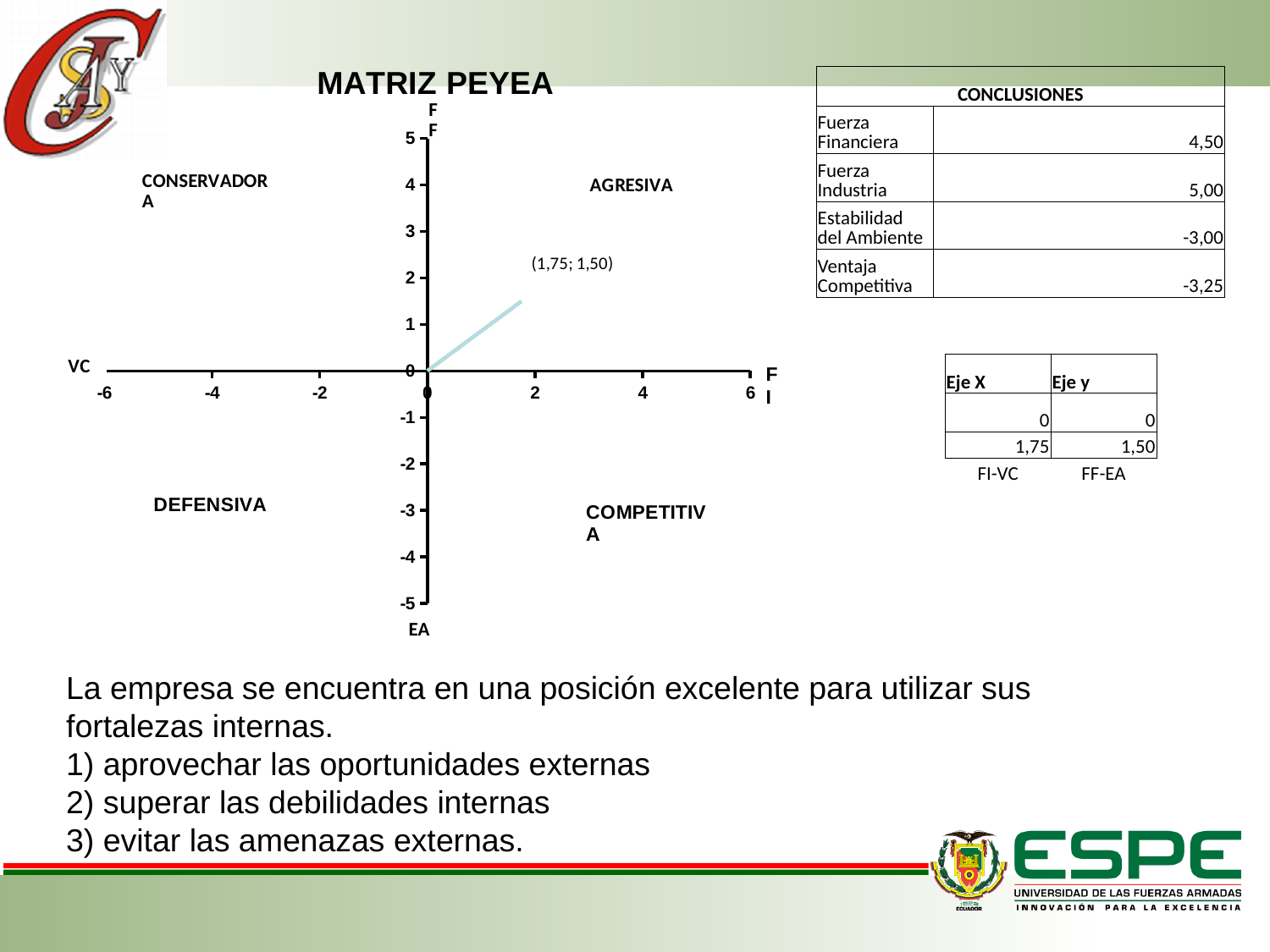
What is the x-coordinate of the labelled point in the MATRIZ PEYEA chart? 1,75 What is the difference between the x-coordinate and the y-coordinate of the labelled point in the MATRIZ PEYEA chart? 0,25 Does the plotted line in the MATRIZ PEYEA chart rise or fall as it moves from left to right? rise Which is larger for the labelled point in the MATRIZ PEYEA chart, the x-coordinate or the y-coordinate? the x-coordinate What is the title of the chart on the slide? MATRIZ PEYEA What is the y-coordinate of the labelled point in the MATRIZ PEYEA chart? 1,50 In which quadrant of the MATRIZ PEYEA chart does the plotted vector end? AGRESIVA What is the maximum value shown on the horizontal axis of the MATRIZ PEYEA chart? 6 What is the minimum value shown on the vertical axis of the MATRIZ PEYEA chart? -5 Is the y-coordinate of the labelled point in the MATRIZ PEYEA chart greater or less than 1? greater Is the x-coordinate of the labelled point in the MATRIZ PEYEA chart greater or less than 2? less What are the coordinates of the labelled end point of the vector in the MATRIZ PEYEA chart? (1,75; 1,50)